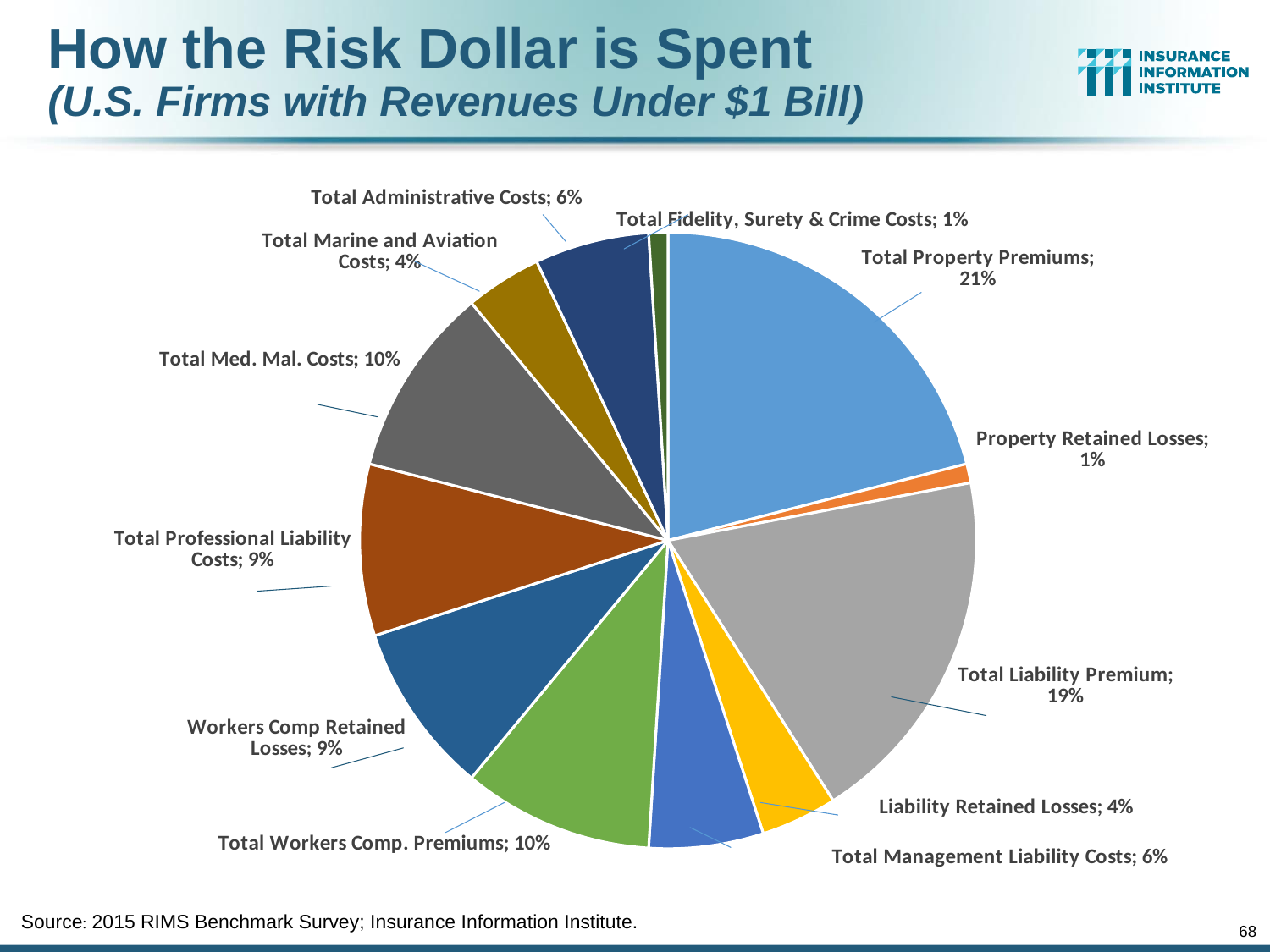
Which category has the largest share of the pie? Total Property Premiums What percentage is shown for Total Marine and Aviation Costs? 4% Which is larger, Total Property Premiums or Total Liability Premium? Total Property Premiums What percentage is shown for Total Med. Mal. Costs? 10% What share of the risk dollar goes to Total Liability Premium? 19% What is the difference in percentage points between Total Property Premiums and Total Liability Premium? 2 percentage points What is the title of the chart on the slide? How the Risk Dollar is Spent (U.S. Firms with Revenues Under $1 Bill) What percentage is shown for Total Fidelity, Surety & Crime Costs? 1% What share of the risk dollar goes to Total Property Premiums? 21% What kind of chart is shown on the slide? Pie chart What is the difference in percentage points between Total Workers Comp. Premiums and Workers Comp Retained Losses? 1 percentage point How many slices does the pie chart have? 12